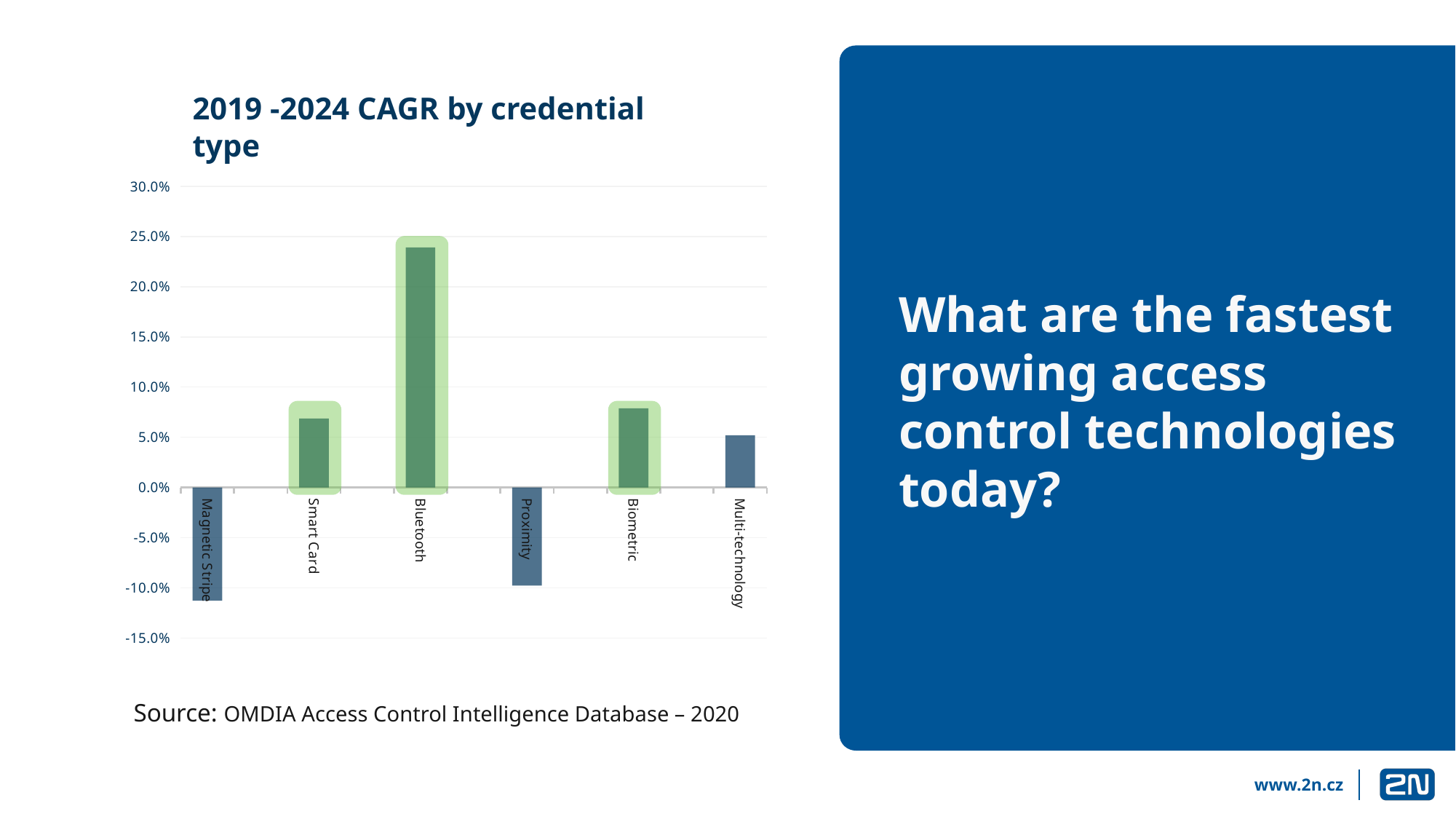
How many credential types are plotted in the chart? 6 Which credential type has the highest CAGR in the chart? Bluetooth What is the title of the chart? 2019 -2024 CAGR by credential type Which has a higher CAGR, Smart Card or Multi-technology? Smart Card Is the value for Multi-technology greater or less than 10.0%? less Which has a higher CAGR, Bluetooth or Biometric? Bluetooth Is the value for Magnetic Stripe greater or less than -10.0%? less What kind of chart is shown on the slide? bar chart Which credential type has the lowest CAGR in the chart? Magnetic Stripe Which three credential types are highlighted in green in the chart? Smart Card, Bluetooth, Biometric Is the value for Bluetooth greater or less than 20.0%? greater